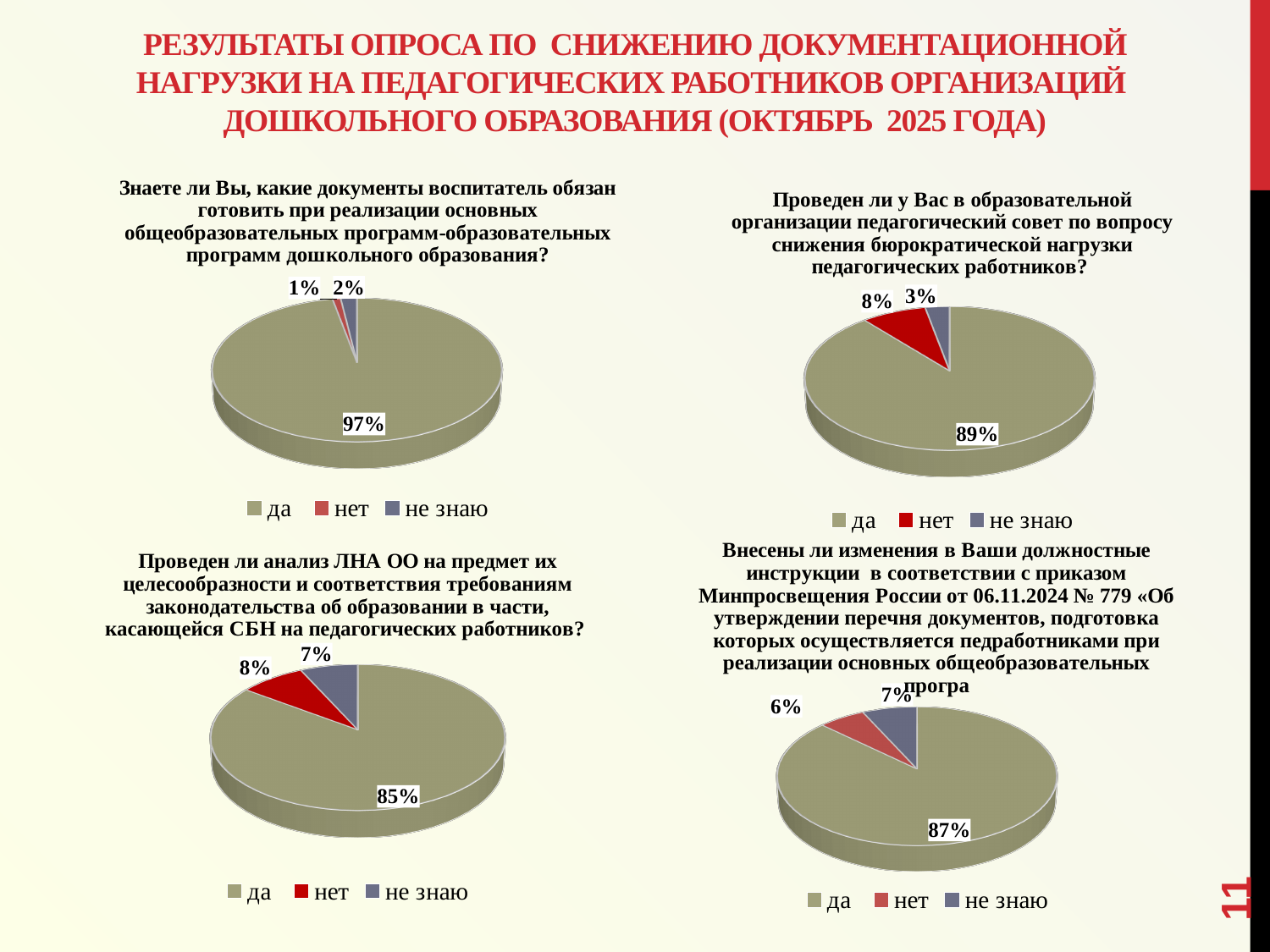
What type of chart is used for each of the four charts on the slide? Pie chart In the bottom-left pie chart, what percentage of respondents answered "да"? 85% How many entries does the legend of the top-left chart list? 3 In the top-left pie chart, what is the combined share of "нет" and "не знаю"? 3% In the top-right pie chart, which answer has the smallest share? не знаю In the bottom-right pie chart, which is larger, the share for "нет" or the share for "не знаю"? не знаю In the top-left pie chart, what percentage of respondents answered "не знаю"? 2% In the bottom-left pie chart, which colour represents the answer "нет"? Red In the bottom-right pie chart, what percentage of respondents answered "нет"? 6% In the bottom-left pie chart, what is the difference between the "нет" and "не знаю" shares? 1% In the top-right pie chart, what percentage of respondents answered "нет"? 8% In the top-left pie chart, what percentage of respondents answered "да"? 97%